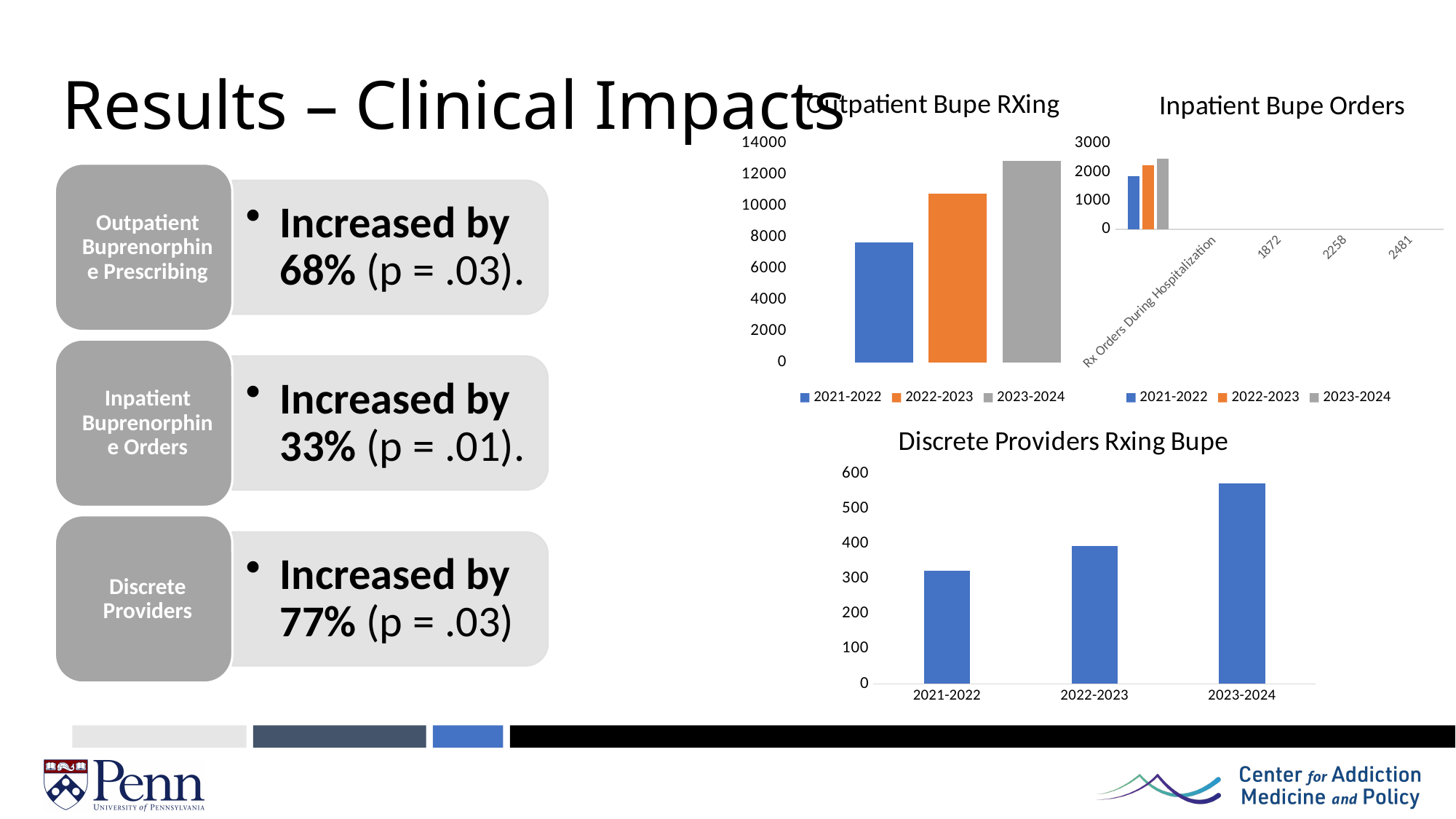
In the "Discrete Providers Rxing Bupe" chart, do the values rise or fall from 2021-2022 to 2023-2024? Rise How many series does the legend of the "Outpatient Bupe RXing" chart list? 3 In the "Outpatient Bupe RXing" chart, is the value for 2023-2024 greater or less than 12000? greater How many categories are shown on the x axis of the "Discrete Providers Rxing Bupe" chart? 3 In the "Inpatient Bupe Orders" chart, which is larger, the bar for 2021-2022 or the bar for 2023-2024? 2023-2024 In the "Outpatient Bupe RXing" chart, which series has the highest bar? 2023-2024 In the "Outpatient Bupe RXing" chart, what colour is the bar for the 2022-2023 series? Orange In the "Outpatient Bupe RXing" chart, which series has the lowest bar? 2021-2022 In the "Discrete Providers Rxing Bupe" chart, is the value for 2023-2024 greater or less than 500? greater What kind of chart is the "Discrete Providers Rxing Bupe" chart? Bar chart In the "Outpatient Bupe RXing" chart, is the value for 2021-2022 greater or less than 8000? less In the "Discrete Providers Rxing Bupe" chart, which category has the highest bar? 2023-2024